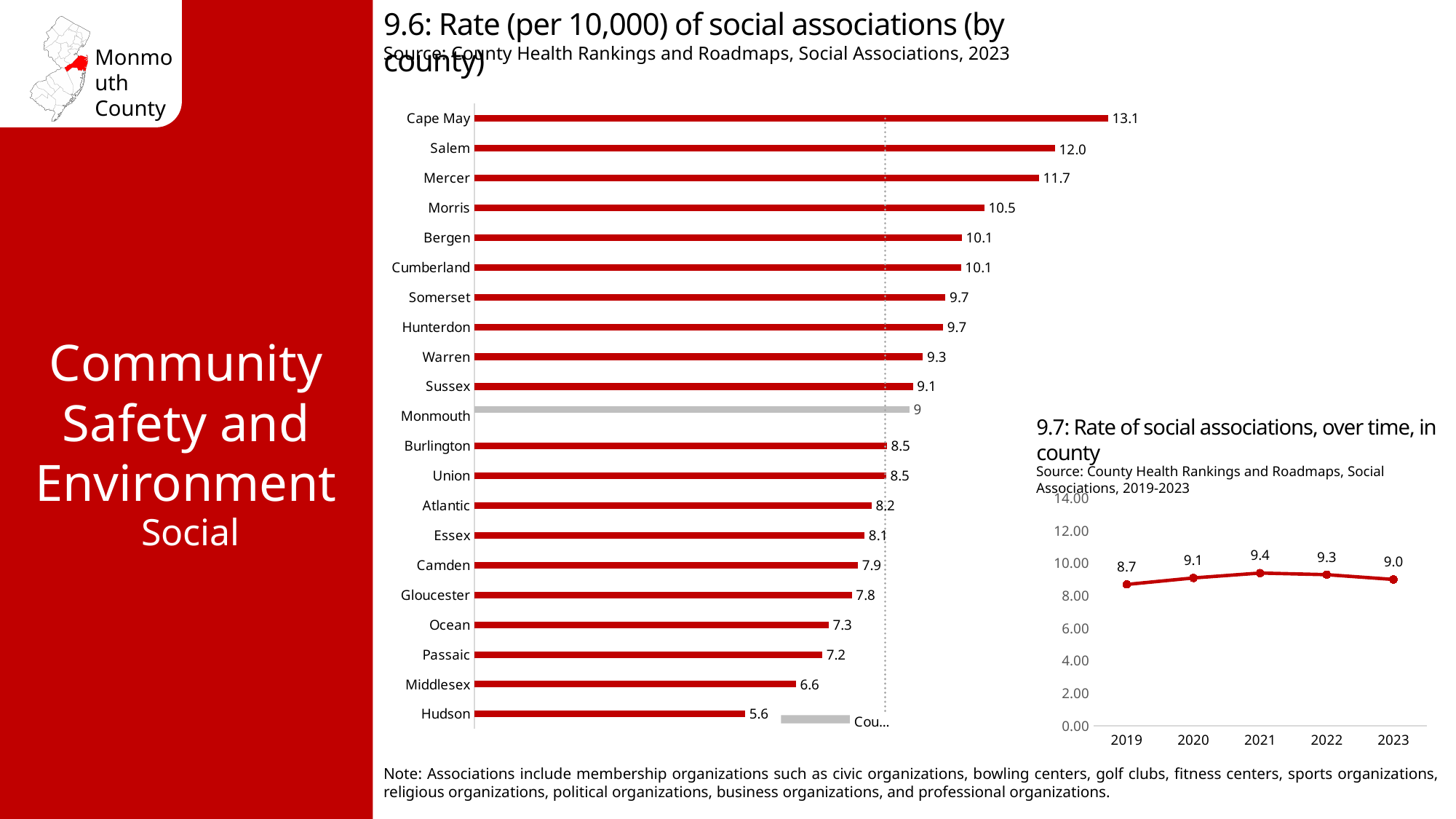
In the chart '9.6: Rate (per 10,000) of social associations (by county)', what is the value for Cape May? 13.1 In the chart '9.7: Rate of social associations, over time, in county', what is the value for 2021? 9.4 In the chart '9.6: Rate (per 10,000) of social associations (by county)', which has a higher rate, Morris or Ocean? Morris In the chart '9.6: Rate (per 10,000) of social associations (by county)', what is the difference between the values for Salem and Hudson? 6.4 What kind of chart is '9.7: Rate of social associations, over time, in county'? Line chart In the chart '9.7: Rate of social associations, over time, in county', what is the difference between the values for 2021 and 2019? 0.7 In the chart '9.6: Rate (per 10,000) of social associations (by county)', how many counties are shown? 21 In the chart '9.6: Rate (per 10,000) of social associations (by county)', which county has the highest rate? Cape May In the chart '9.6: Rate (per 10,000) of social associations (by county)', what is the value for Monmouth? 9 What kind of chart is '9.6: Rate (per 10,000) of social associations (by county)'? Bar chart In the chart '9.7: Rate of social associations, over time, in county', which year has the lowest value? 2019 In the chart '9.6: Rate (per 10,000) of social associations (by county)', which county has the lowest rate? Hudson